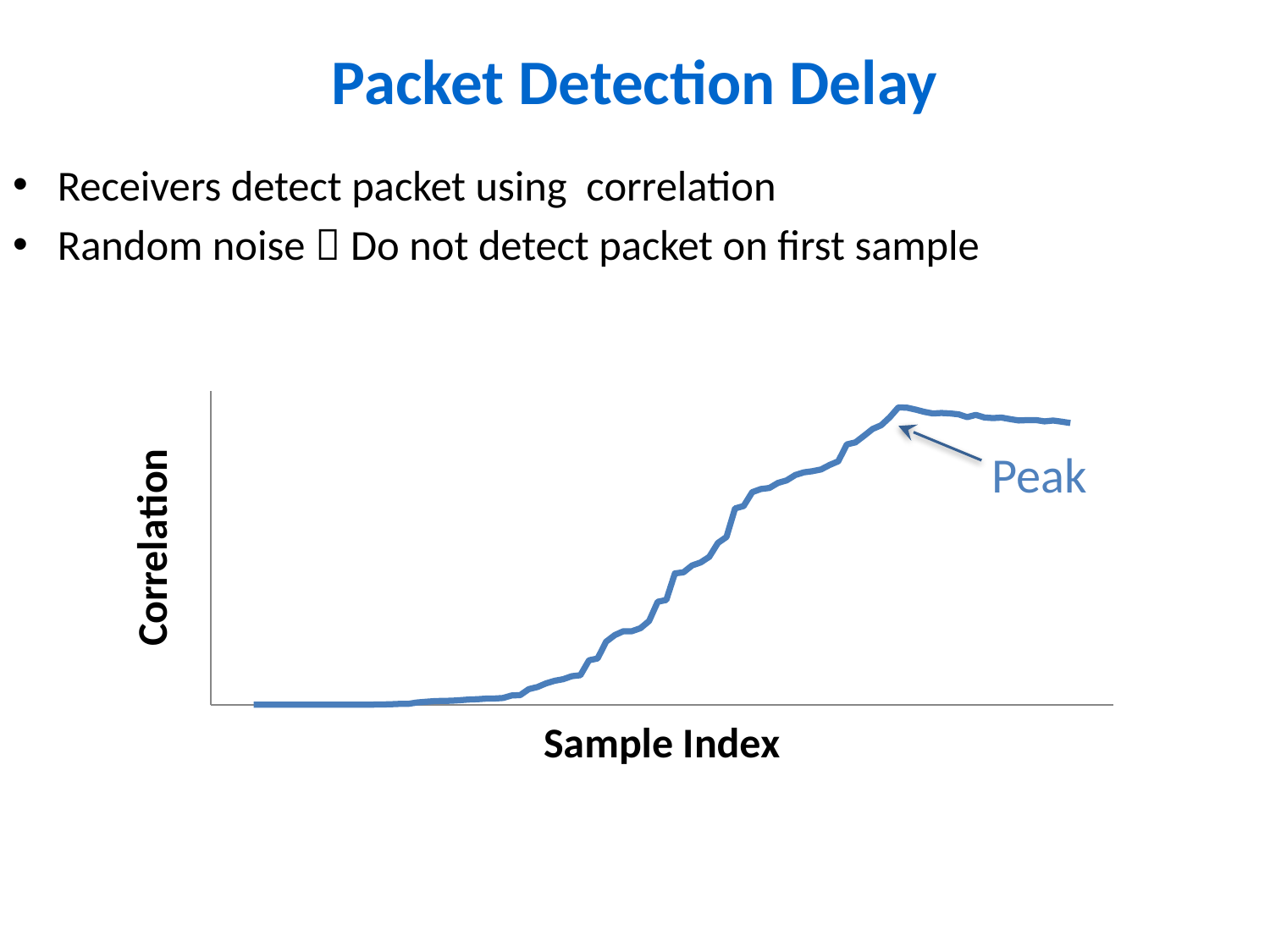
Is the highest point of the line near the left or near the right of the chart? near the right After the point labelled Peak, does the line rise or fall? fall What kind of chart is shown on the slide? line chart How many lines are plotted on the chart? 1 What are the titles of the y axis and the x axis of the chart? Correlation and Sample Index What word does the arrow annotation on the chart point to the highest point with? Peak Is the lowest part of the line near the left or near the right of the chart? near the left Is the correlation at the left end of the line higher or lower than at the right end? lower Does the correlation generally rise or fall as the sample index increases? rise